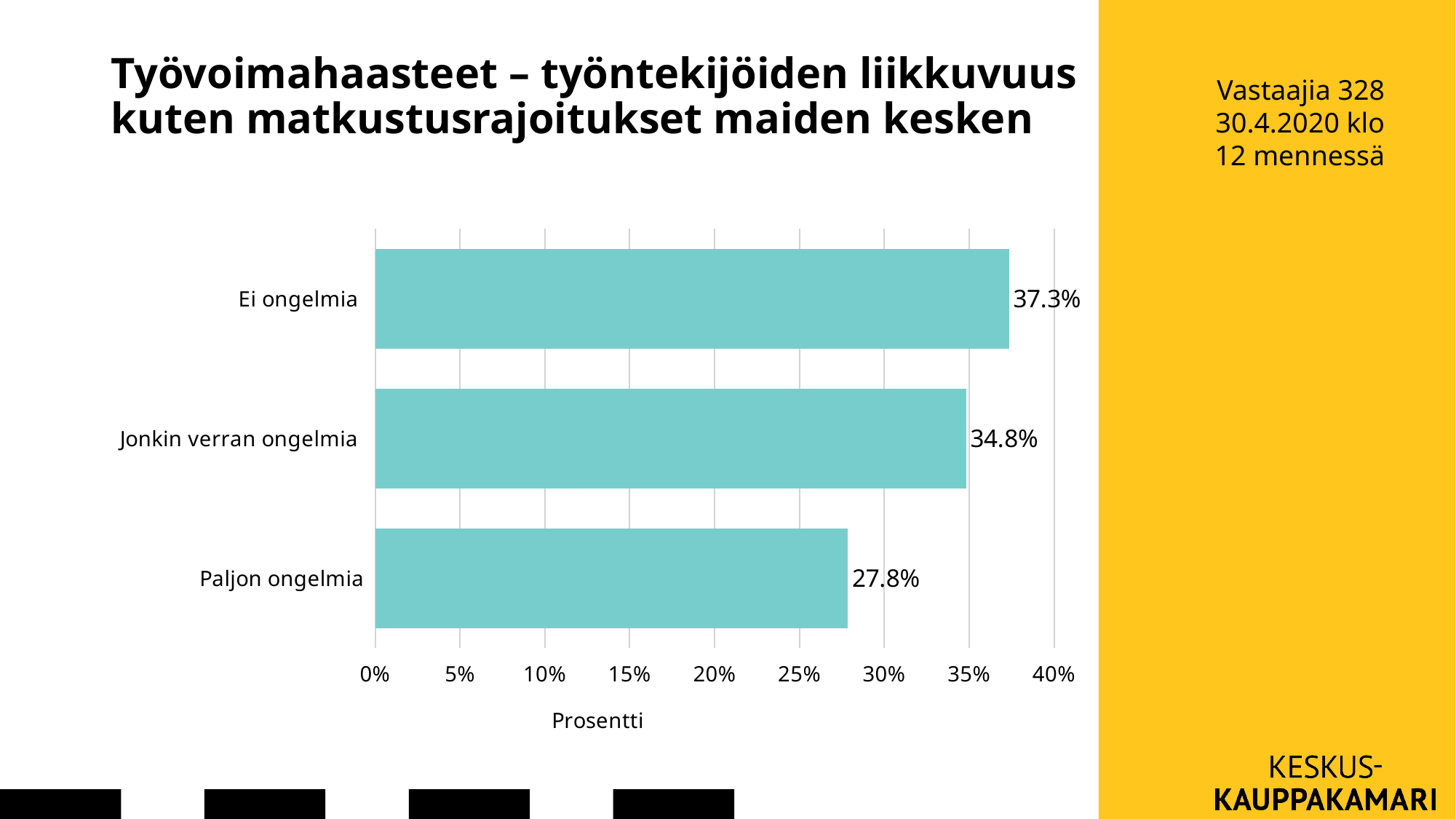
Which category has the lowest value? Paljon ongelmia How many categories are shown in the chart? 3 Which is larger, the value for Jonkin verran ongelmia or the value for Paljon ongelmia? Jonkin verran ongelmia What is the difference between the values for Ei ongelmia and Jonkin verran ongelmia? 2.5% What is the value for Ei ongelmia? 37.3% What kind of chart is shown on the slide? bar chart Which category has the highest value? Ei ongelmia What is the difference between the values for Ei ongelmia and Paljon ongelmia? 9.5% Is the value for Paljon ongelmia greater or less than 30%? less What is the label of the horizontal axis? Prosentti What is the value for Jonkin verran ongelmia? 34.8% What is the value for Paljon ongelmia? 27.8%